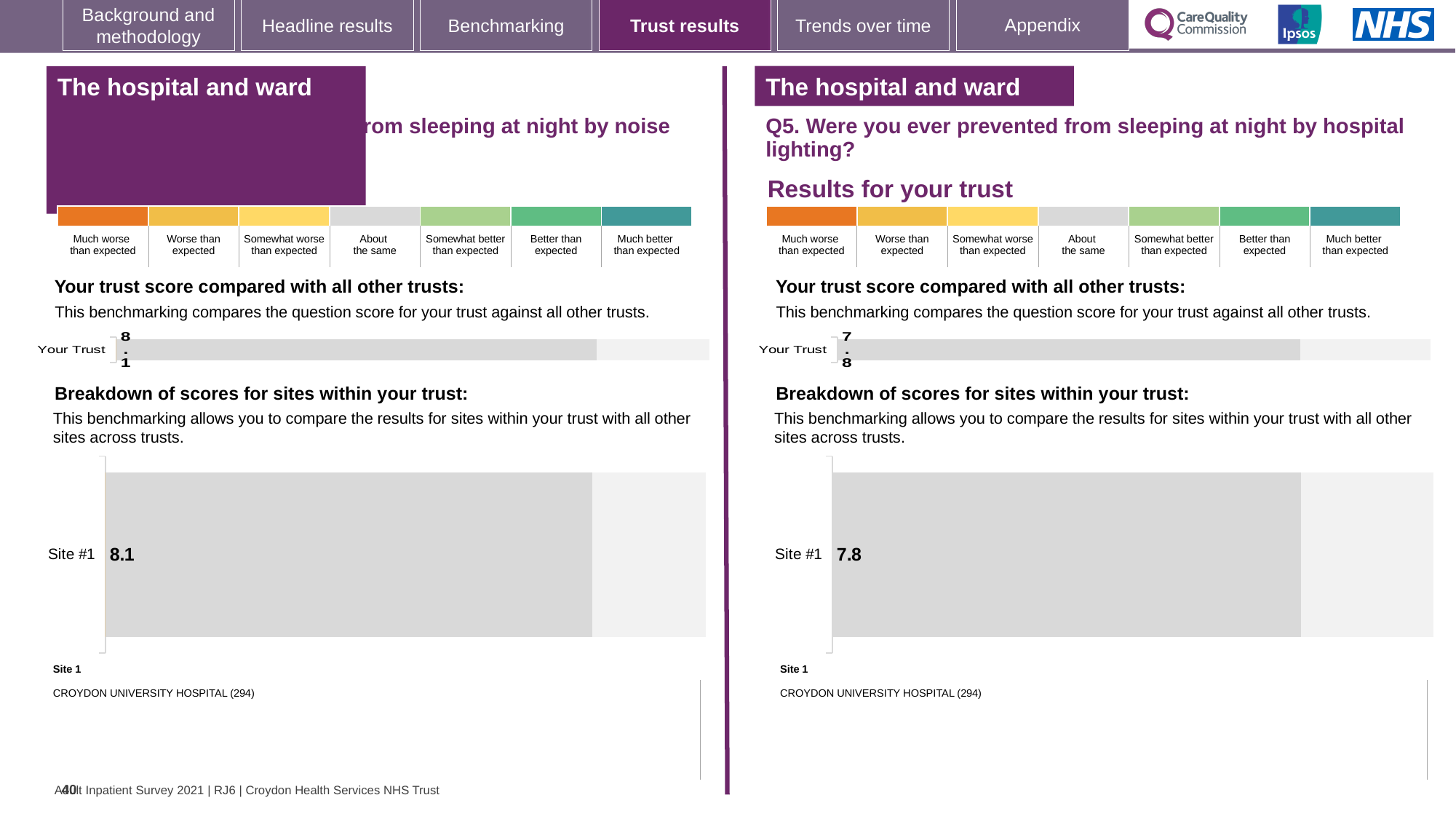
On the right-hand 'Your trust score compared with all other trusts' chart (Q5, hospital lighting), what is the value for Your Trust? 7.8 Which hospital is listed as Site 1 beneath the breakdown charts? CROYDON UNIVERSITY HOSPITAL (294) On the right-hand slide section (Q5, hospital lighting), what score is shown for Site #1 in the breakdown of scores chart? 7.8 Comparing the Site #1 bars, which is larger: the left-hand chart (noise) or the right-hand chart (Q5, hospital lighting)? The left-hand chart (noise) On the right-hand chart (Q5, hospital lighting), is the Site #1 score the same as the Your Trust score? Yes What number appears in parentheses after the Site 1 hospital name beneath the breakdown charts? 294 On the left-hand slide section (sleeping at night by noise), what score is shown for Site #1 in the breakdown of scores chart? 8.1 What kind of chart is used for the 'Breakdown of scores for sites within your trust' on the left-hand side? Bar chart On the left-hand 'Your trust score compared with all other trusts' chart, what is the value for Your Trust? 8.1 What is the difference between the Site #1 score on the left-hand chart (8.1) and the Site #1 score on the right-hand chart (7.8)? 0.3 How many sites are shown in the 'Breakdown of scores for sites within your trust' chart on the right-hand side? 1